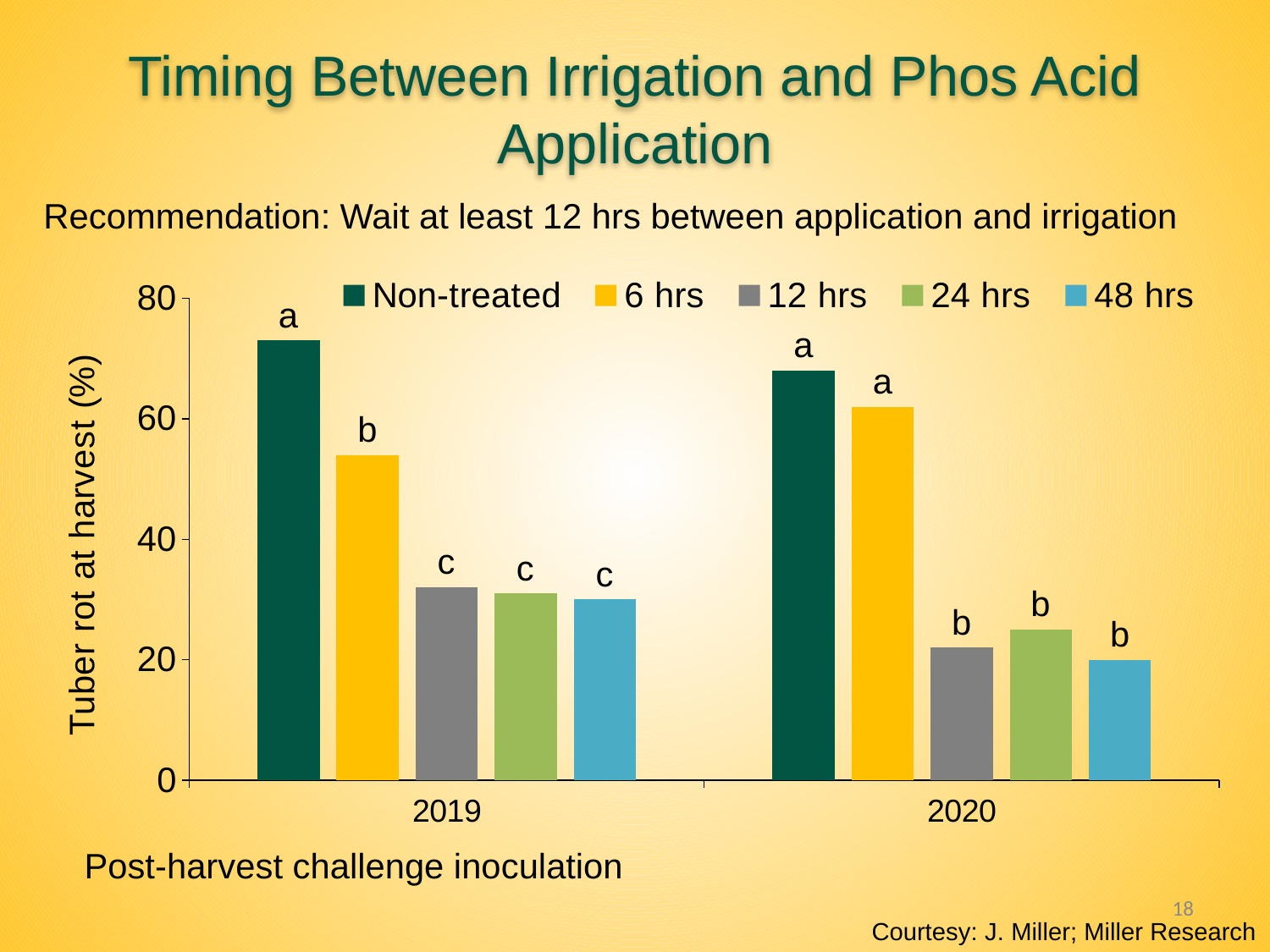
Is the value for 6 hrs in 2019 greater or less than 60? less Which is larger, the 6 hrs value in 2019 or the 6 hrs value in 2020? 2020 How many series does the legend list? 5 How many year categories are shown on the x axis? 2 What is the label on the y axis? Tuber rot at harvest (%) What kind of chart is shown on the slide? bar chart Is the value for 6 hrs in 2020 greater or less than 40? greater Which treatment has the highest tuber rot at harvest in 2019? Non-treated Which is larger, the Non-treated value in 2019 or the Non-treated value in 2020? 2019 Is the value for 12 hrs in 2020 greater or less than 40? less Which treatment has the highest tuber rot at harvest in 2020? Non-treated